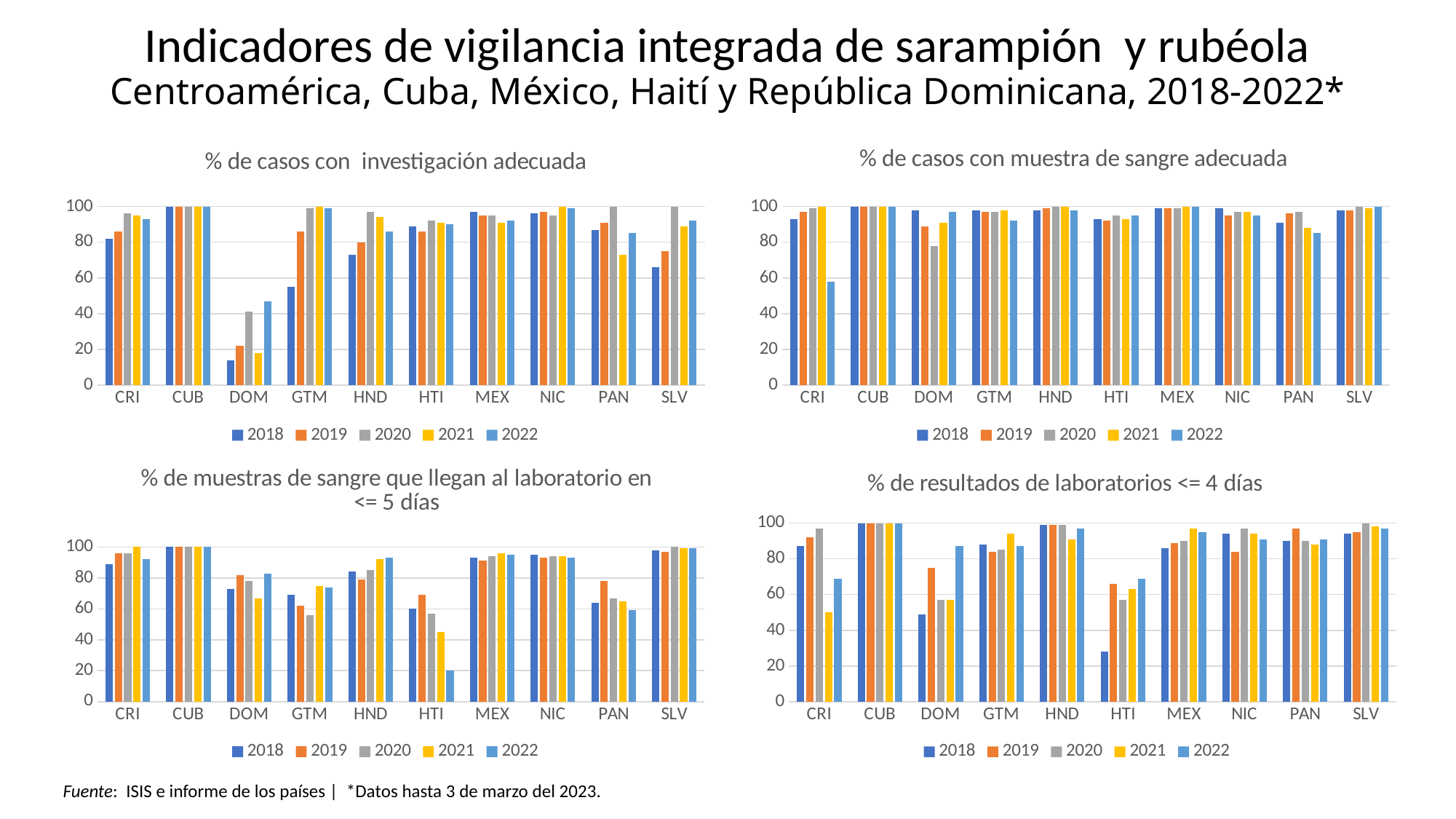
How many series does the legend of the "% de resultados de laboratorios <= 4 días" chart list? 5 In the "% de casos con investigación adecuada" chart, which is larger for DOM: the 2018 value or the 2022 value? 2022 How many countries are shown on the x axis of the "% de casos con muestra de sangre adecuada" chart? 10 In the "% de casos con investigación adecuada" chart, which country has the lowest value in 2018? DOM In the "% de resultados de laboratorios <= 4 días" chart, which is larger for HTI: the 2018 value or the 2019 value? 2019 In the "% de casos con investigación adecuada" chart, is the value for DOM in 2018 greater or less than 20? less In the "% de muestras de sangre que llegan al laboratorio en <= 5 días" chart, is the value for HTI in 2021 greater or less than 40? greater In the "% de resultados de laboratorios <= 4 días" chart, is the value for HTI in 2018 greater or less than 40? less In the "% de casos con muestra de sangre adecuada" chart, which country has the lowest value in 2022? CRI What kind of chart is "% de casos con investigación adecuada"? bar chart In the "% de muestras de sangre que llegan al laboratorio en <= 5 días" chart, which country has the lowest value in 2022? HTI